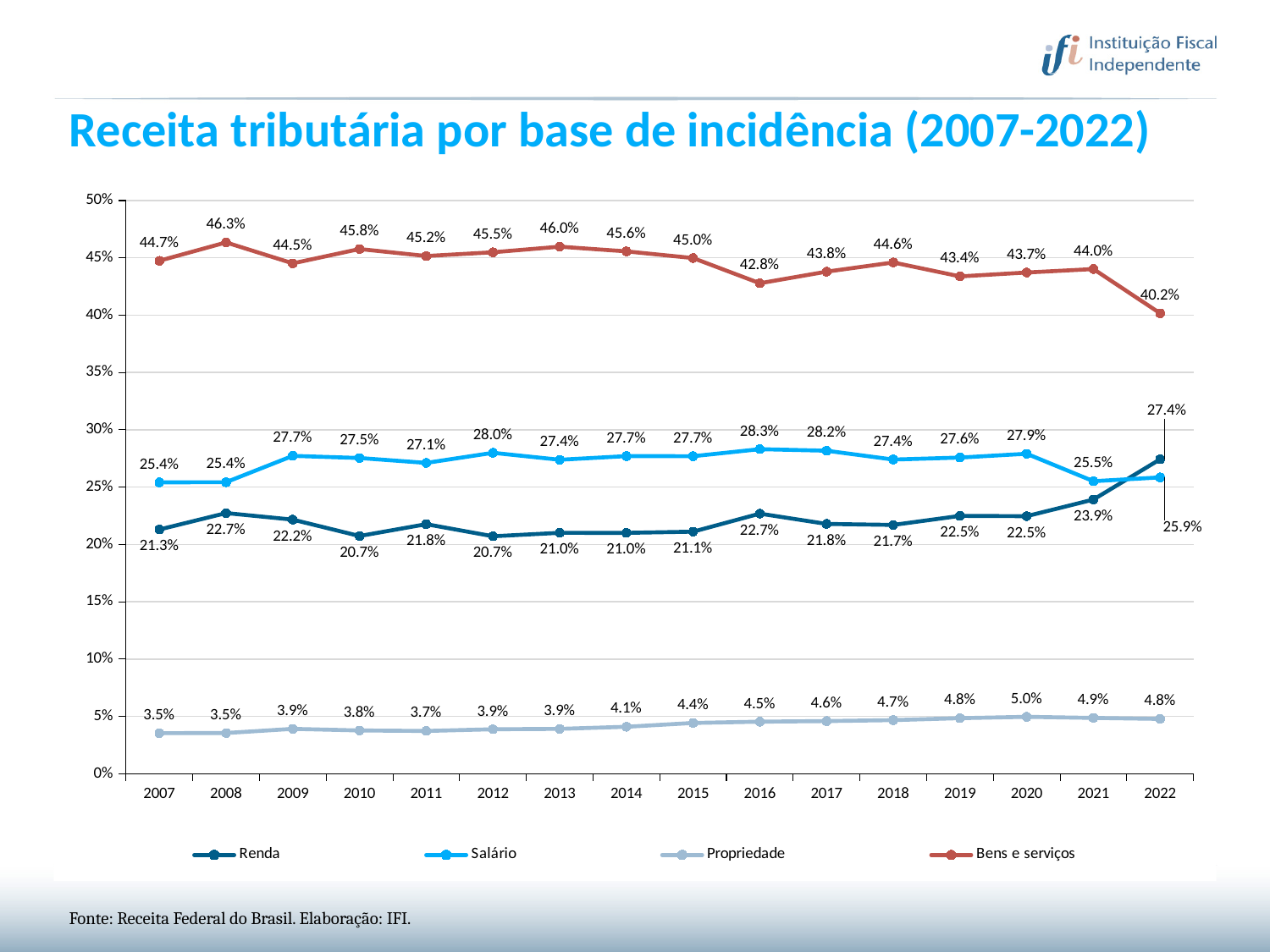
What type of chart is shown on the slide? line chart What is the value for Renda in 2022? 27.4% What is the title of the chart? Receita tributária por base de incidência (2007-2022) Which is larger in 2022, Renda or Salário? Renda In which year does Bens e serviços reach its lowest value? 2022 Does the Propriedade series generally rise or fall from 2007 to 2020? rise How many years are shown on the x axis? 16 In which year does Bens e serviços reach its highest value? 2008 How many series does the legend list? 4 What is the difference between the Salário value in 2016 and in 2022? 2.4% What is the value for Propriedade in 2020? 5.0% What is the value for Bens e serviços in 2022? 40.2%